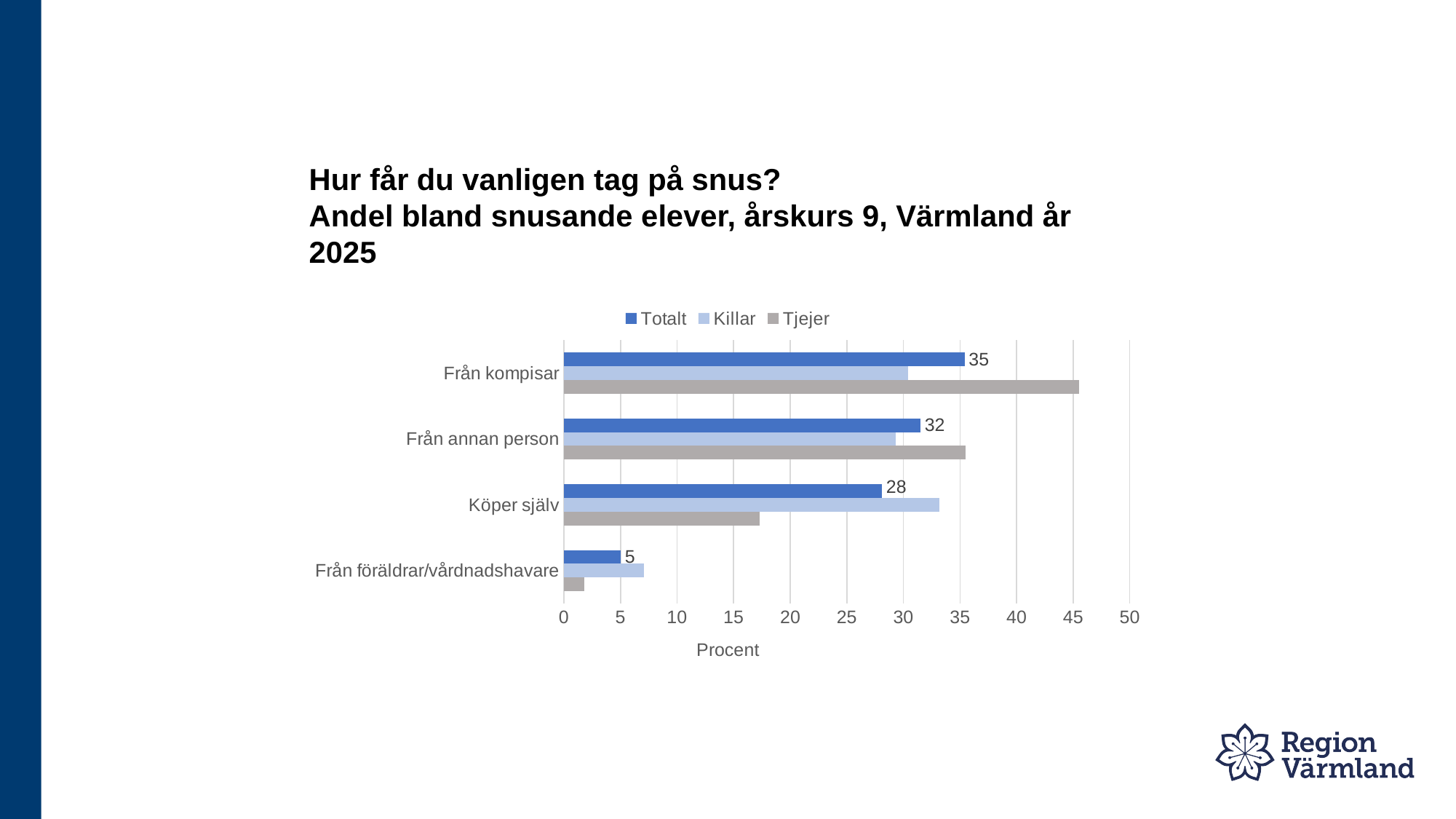
Is the Tjejer value for Från kompisar greater or less than 40? greater Is the Tjejer value for Köper själv greater or less than 20? less What is the Totalt value for Från annan person? 32 What is the Totalt value for Köper själv? 28 Which category has the highest Totalt value? Från kompisar Which category has the lowest Totalt value? Från föräldrar/vårdnadshavare How many series does the legend list? 3 What is the Totalt value for Från föräldrar/vårdnadshavare? 5 For Köper själv, which series has the larger value, Killar or Tjejer? Killar What is the difference between the Totalt values for Från kompisar and Köper själv? 7 What kind of chart is shown on the slide? Bar chart What is the Totalt value for Från kompisar? 35